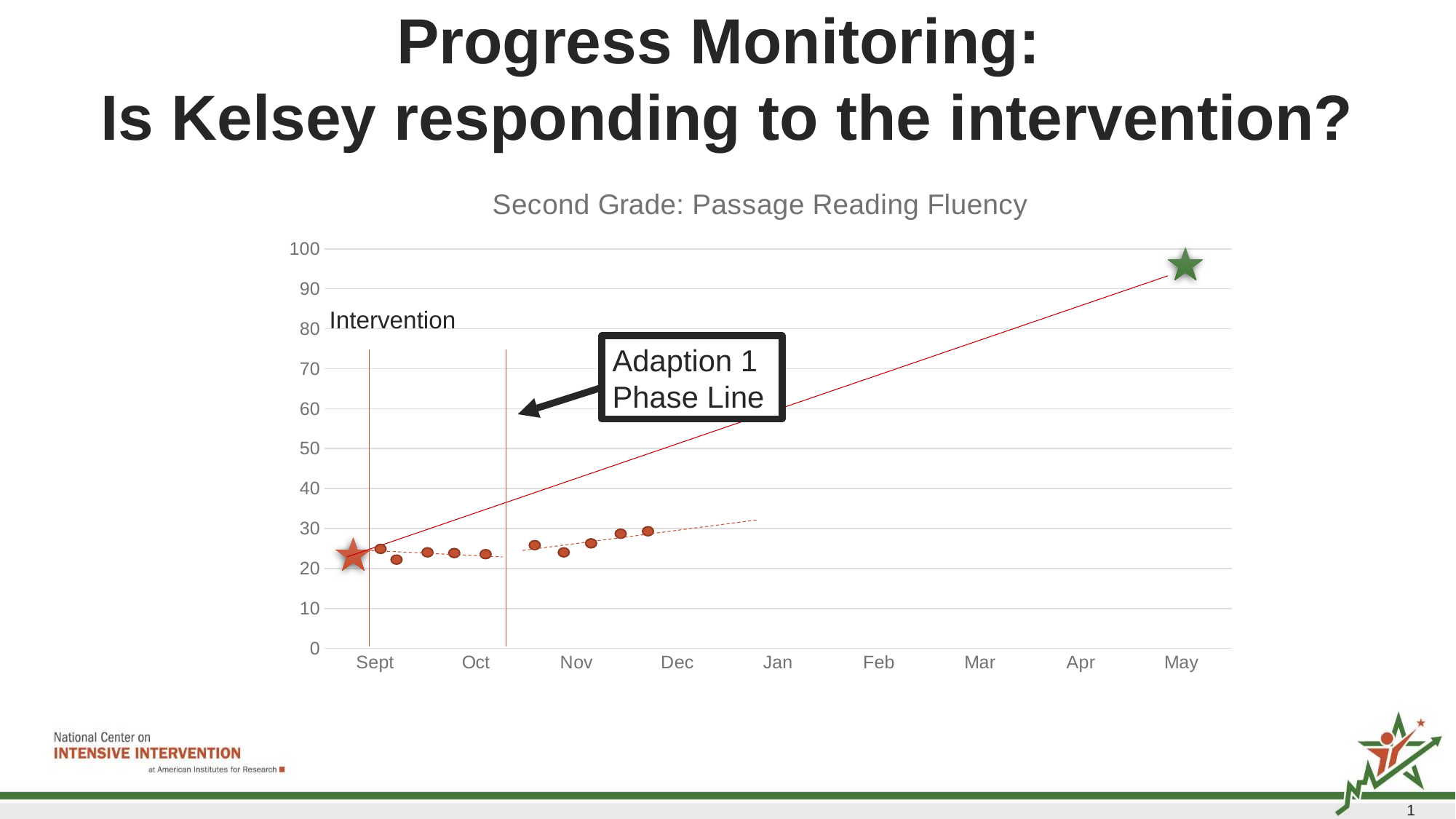
What does the boxed label with the arrow pointing to the second vertical line say? Adaption 1 Phase Line What kind of chart is shown on the slide? line chart Which month is the last label on the x axis? May Which month is the first label on the x axis? Sept How many progress-monitoring data points (dots) are plotted on the chart? 10 Is the first progress-monitoring data point in Sept greater or less than 30? less How many months are labelled on the x axis of the chart? 9 What is the title of the chart? Second Grade: Passage Reading Fluency Are all of the plotted progress-monitoring data points greater or less than 40? less Do the progress-monitoring data points after the phase line generally rise or fall over time? rise Is the value of the green goal star in May greater or less than 90? greater What is the highest value shown on the y axis? 100